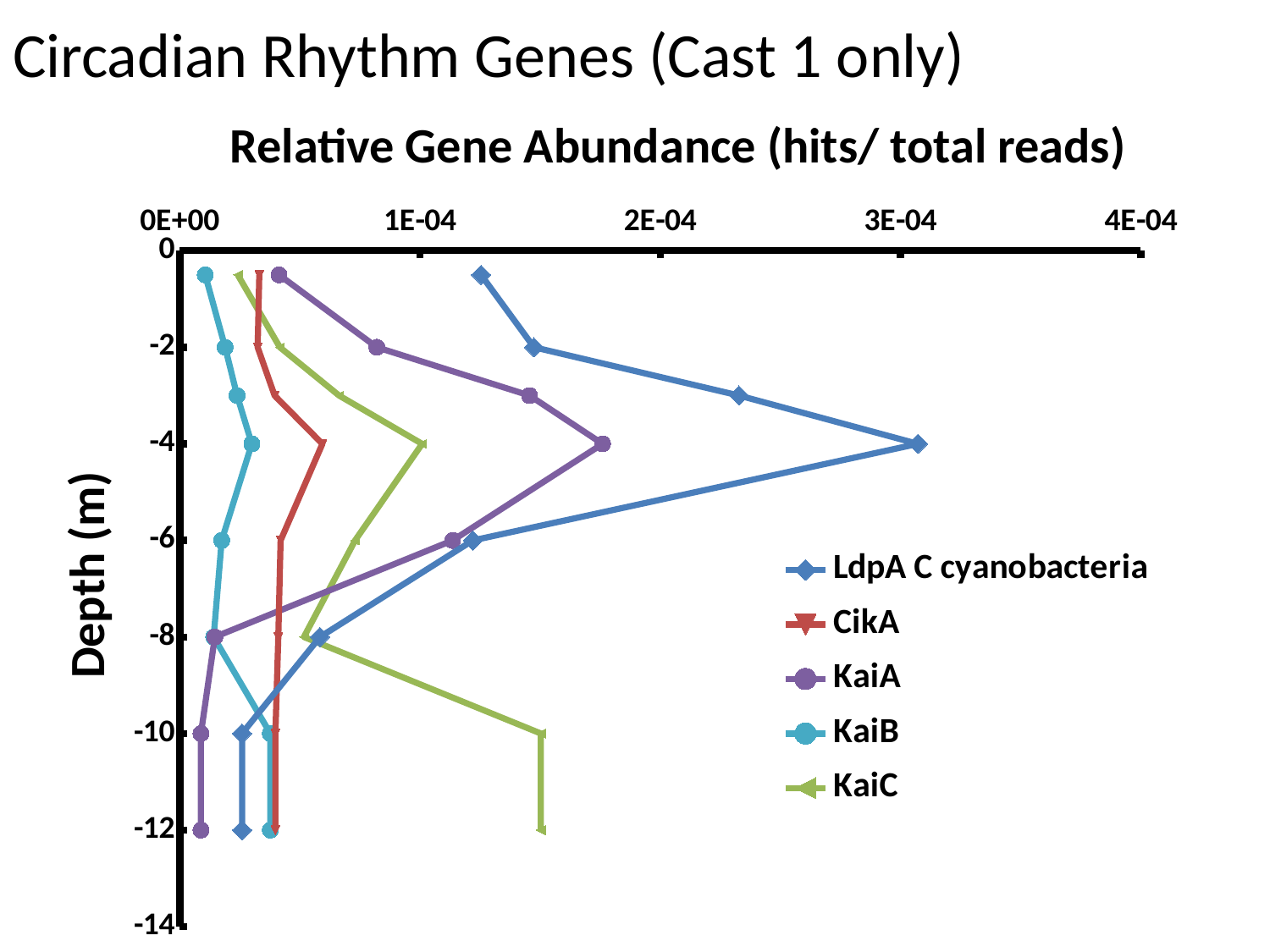
At depth -10, which series has the larger value, KaiC or KaiB? KaiC Is the value for KaiA at depth -4 greater or less than 2E-04? less Is the value for CikA at depth -4 greater or less than 1E-04? less Is the value for KaiC at depth -10 greater or less than 1E-04? greater How many series does the legend list? 5 What is the y-axis title of the chart? Depth (m) What is the x-axis title of the chart? Relative Gene Abundance (hits/ total reads) At which depth does the LdpA C cyanobacteria series reach its maximum value? -4 What kind of chart is shown on the slide? line chart Which series reaches the highest relative gene abundance on the chart? LdpA C cyanobacteria